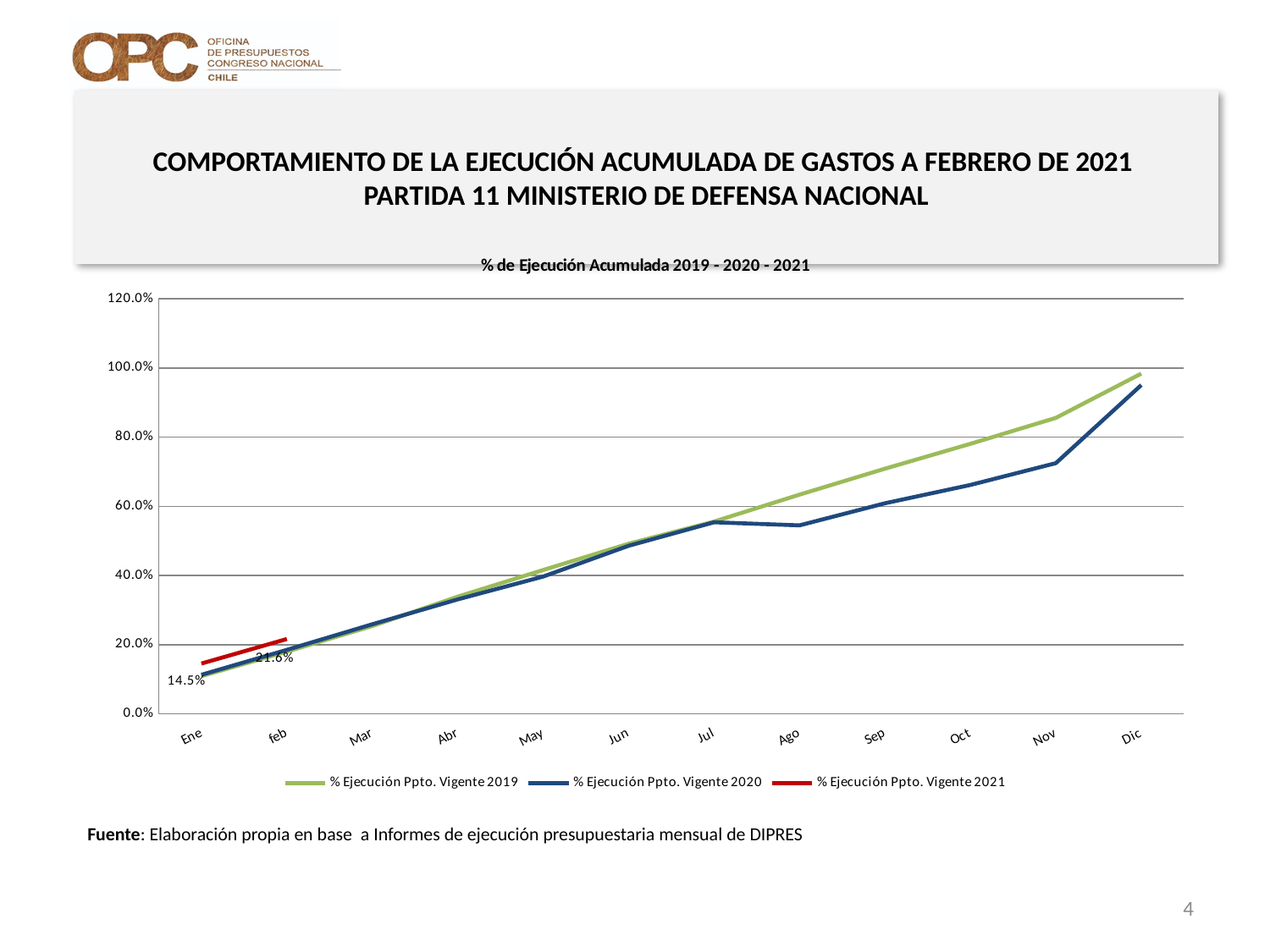
How many months are shown along the x axis? 12 Is the value for % Ejecución Ppto. Vigente 2020 in Nov greater or less than 80.0%? less How many series does the legend list? 3 What is the value of % Ejecución Ppto. Vigente 2021 for Ene? 14.5% Does the % Ejecución Ppto. Vigente 2019 line rise or fall from Ene to Dic? rise What is the title of the chart? % de Ejecución Acumulada 2019 - 2020 - 2021 In Nov, which series is higher: % Ejecución Ppto. Vigente 2019 or % Ejecución Ppto. Vigente 2020? % Ejecución Ppto. Vigente 2019 Is the value for % Ejecución Ppto. Vigente 2020 in Ago greater or less than 60.0%? less By how much did % Ejecución Ppto. Vigente 2021 increase from Ene to feb? 7.1% Is the value for % Ejecución Ppto. Vigente 2019 in Dic greater or less than 80.0%? greater What is the value of % Ejecución Ppto. Vigente 2021 for feb? 21.6% What kind of chart is shown on the slide? line chart